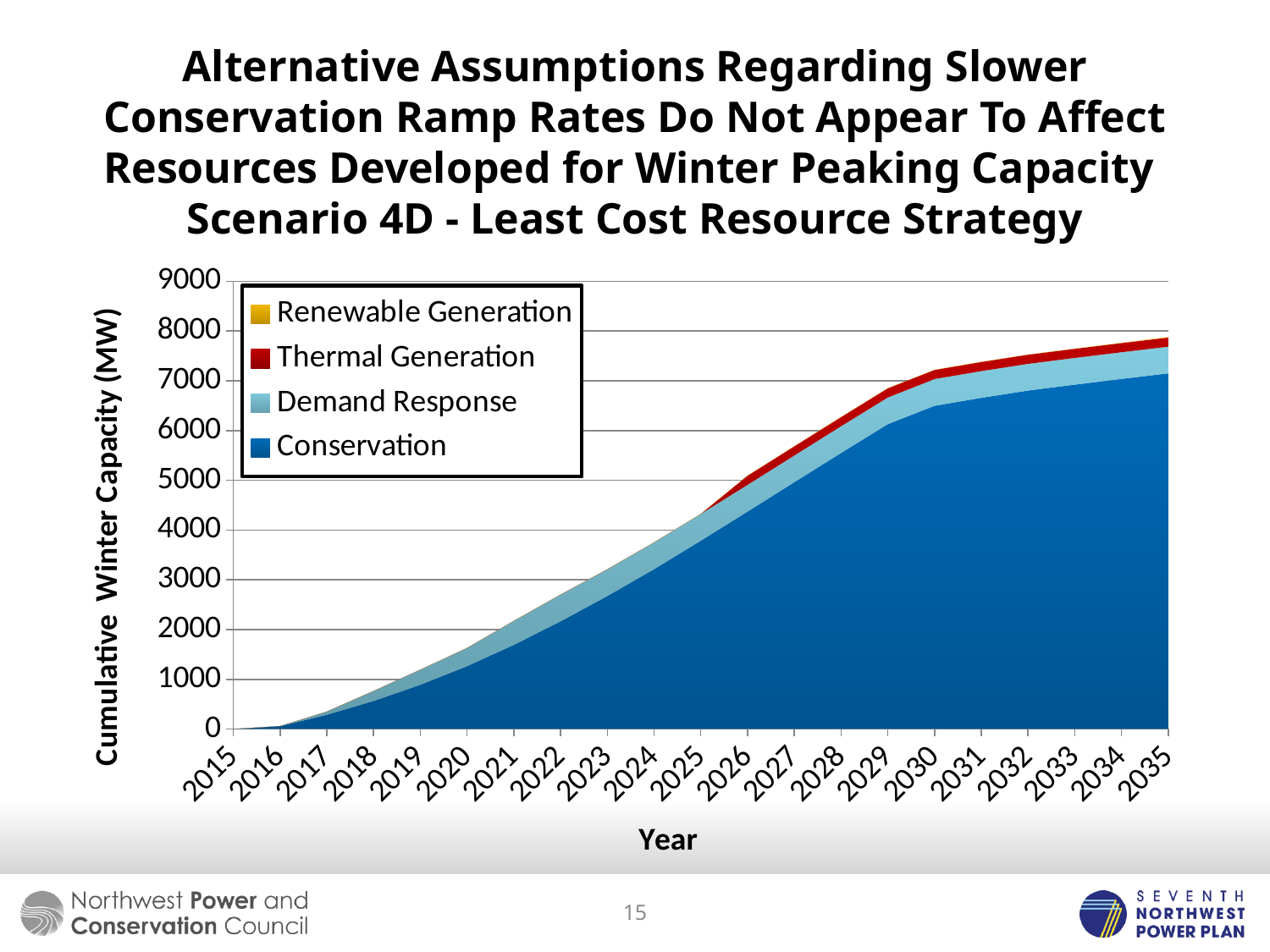
Is the total cumulative winter capacity in 2035 greater or less than 7000 MW? greater Is the total cumulative winter capacity in 2035 larger than in 2025? Yes, 2035 How many series does the legend list? 4 What kind of chart is shown on the slide? Stacked area chart Is the Conservation value in 2030 greater or less than 6000 MW? greater Is the total cumulative winter capacity in 2025 greater or less than 5000 MW? less What is the label of the y axis? Cumulative Winter Capacity (MW) Which series is listed last in the legend? Conservation Which series accounts for the largest share of cumulative winter capacity in 2035? Conservation Does the cumulative winter capacity rise or fall from 2015 to 2035? Rise How many years are shown along the x axis? 21